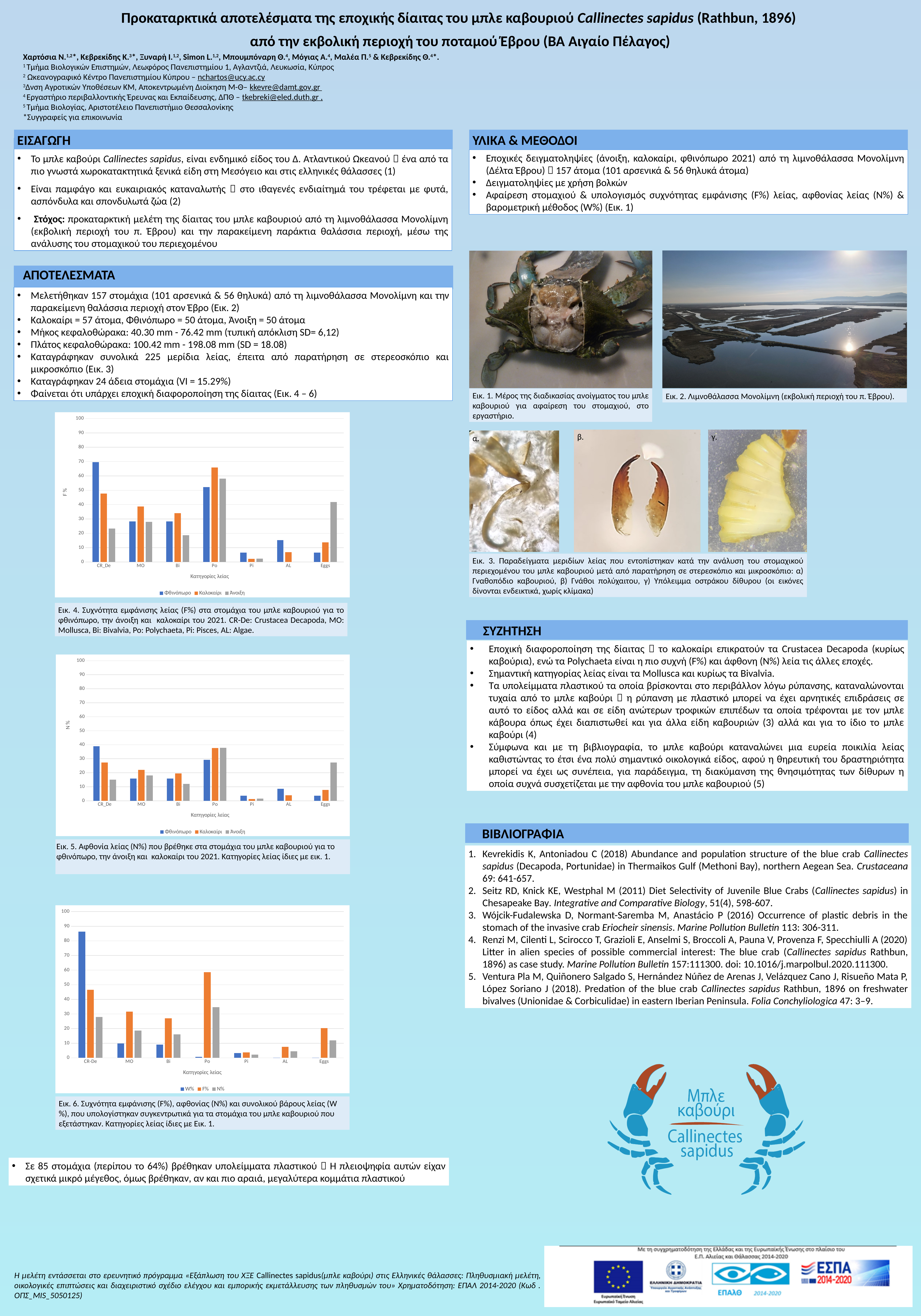
In the chart in Εικ. 4 (F%), how many prey categories are shown on the x axis? 7 In the chart in Εικ. 5 (N%), which prey category has the highest value for the Καλοκαίρι series? Po In the chart in Εικ. 4 (F%), is the Φθινόπωρο value for CR_De greater or less than 60? greater What kind of chart is the chart in Εικ. 4 (top chart on the left)? bar chart In the chart in Εικ. 4 (F%), which prey category has the highest value for the Άνοιξη series? Po In the chart in Εικ. 4 (F%), which prey category has the highest value for the Φθινόπωρο series? CR_De In the chart in Εικ. 6 (bottom chart on the left), what are the three series listed in the legend? W%, F%, N% In the chart in Εικ. 6, is the W% value for CR-De greater or less than 80? greater In the chart in Εικ. 4 (F%), for the Po category, which series is larger: Καλοκαίρι or Φθινόπωρο? Καλοκαίρι In the chart in Εικ. 4 (F%), how many series does the legend list? 3 In the chart in Εικ. 5 (N%), is the Φθινόπωρο value for CR_De greater or less than 30? greater